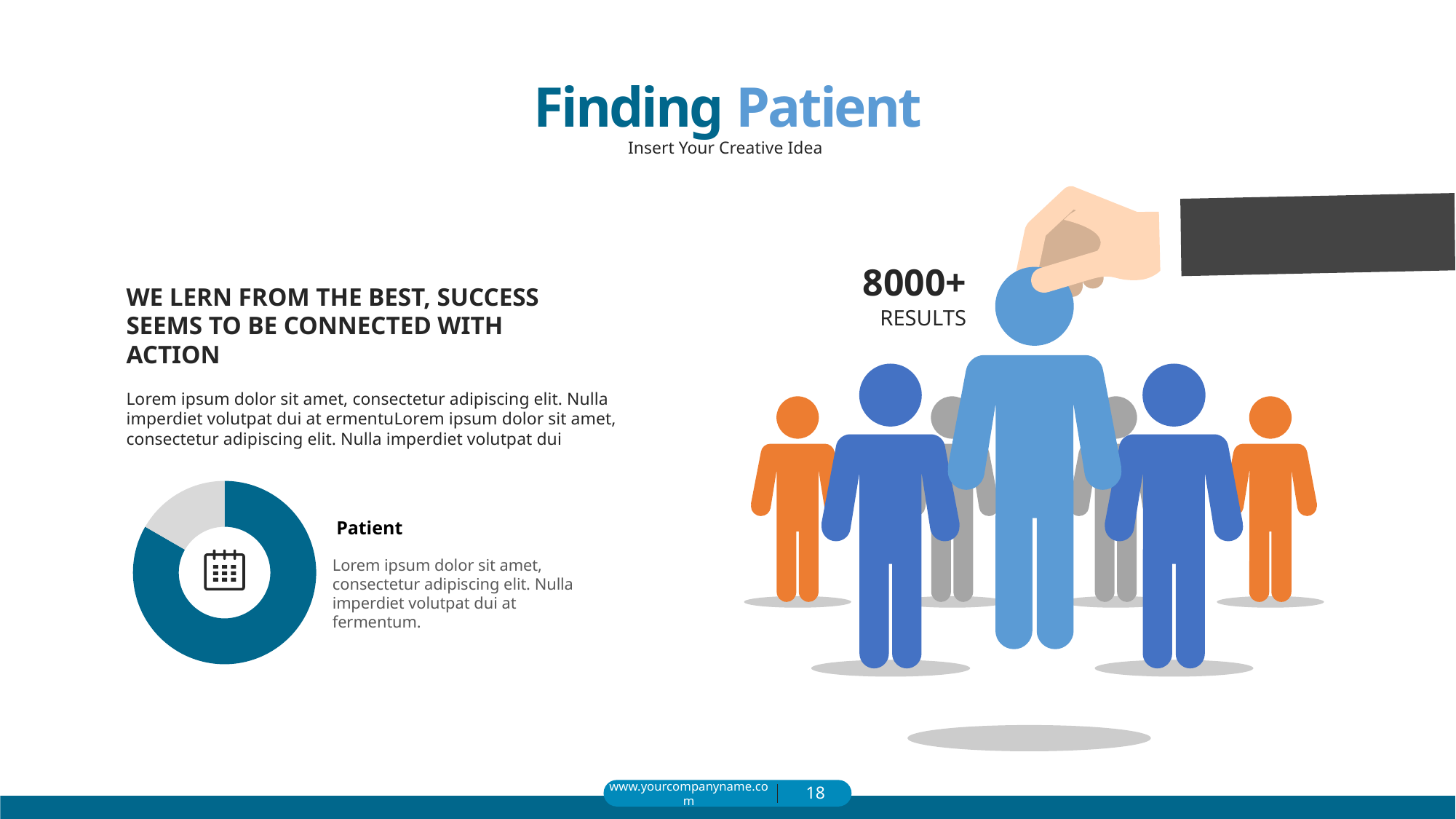
In the donut chart on the left of the slide, which slice is the smallest? The grey slice What kind of chart is shown on the left side of the slide next to the word "Patient"? Pie chart (donut) What icon is shown in the centre of the donut chart on the left of the slide? A calendar icon How many slices does the donut chart on the left of the slide have? 2 In the donut chart on the left of the slide, which slice is larger, the dark teal one or the grey one? The dark teal one What label appears next to the donut chart on the left of the slide? Patient